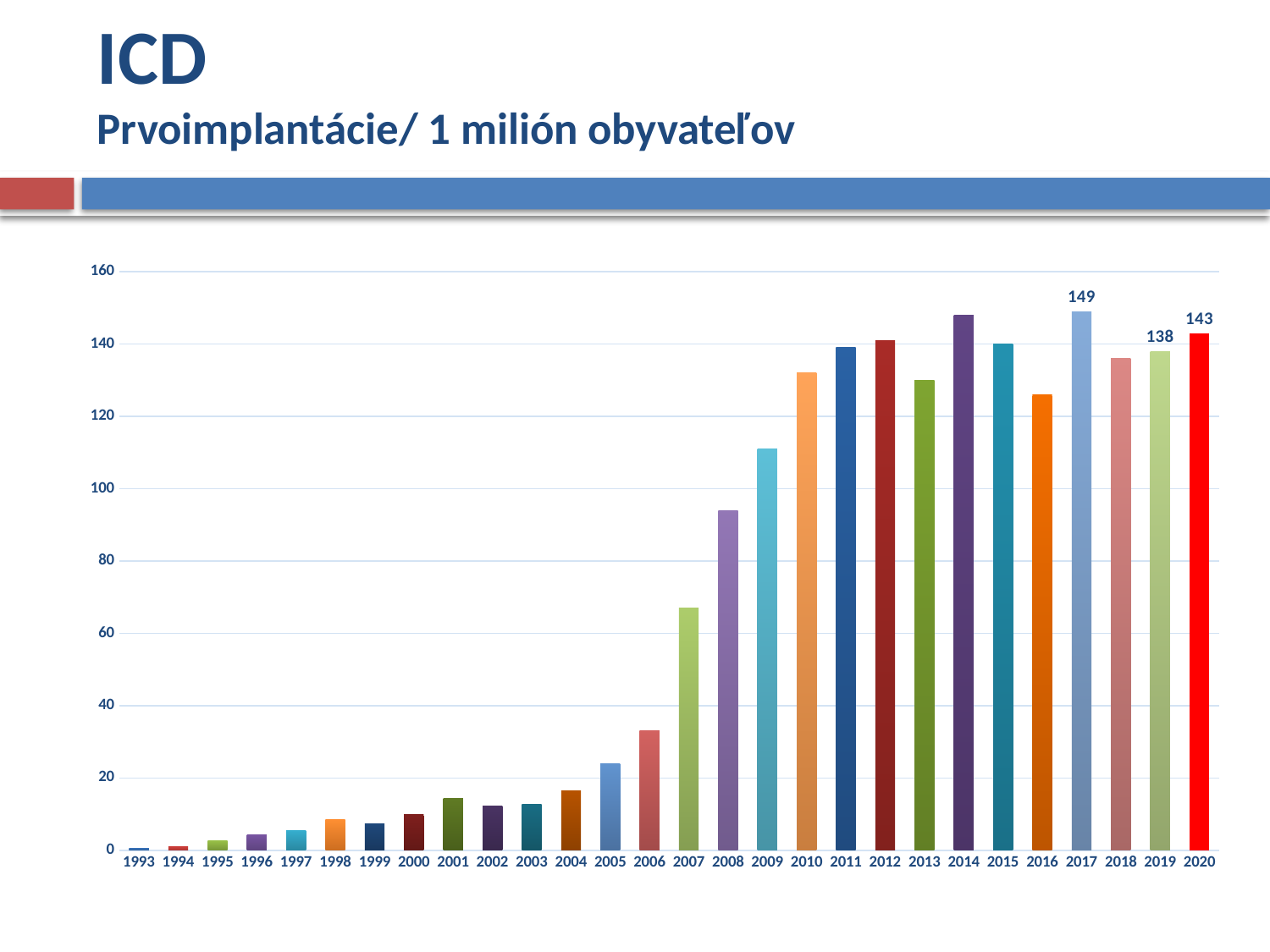
What is the difference between the values for 2020 and 2019? 5 Do the values generally rise or fall from 1993 to 2020? rise What is the value for 2019? 138 What is the difference between the values for 2017 and 2020? 6 What kind of chart is shown on the slide? bar chart Which year has the lowest value? 1993 Is the value for 2008 greater or less than 100? less Which is larger, the value for 2017 or the value for 2020? 2017 Is the value for 2010 greater or less than 120? greater How many years are shown on the x axis? 28 What is the value for 2017? 149 What is the value for 2020? 143